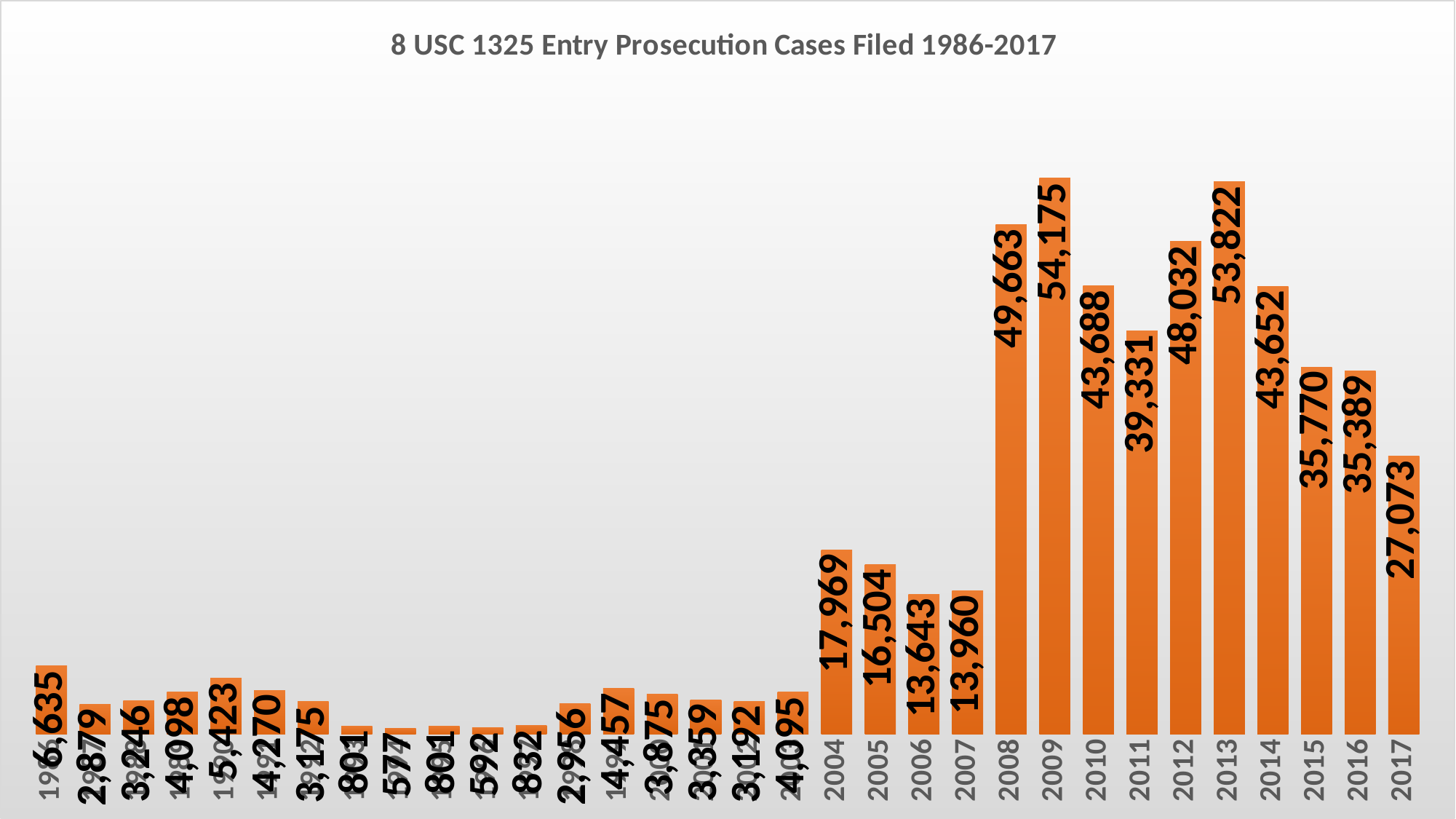
Do the values rise or fall from 2013 to 2017? Fall What is the difference between the cases filed in 2009 and in 2013? 353 Which year has the highest number of cases filed? 2009 How many cases were filed in 2004? 17,969 How many years (bars) are shown in the chart? 32 How many cases were filed in 2009? 54,175 What type of chart is shown on the slide? Bar chart How many cases were filed in 2012? 48,032 What is the title of the chart? 8 USC 1325 Entry Prosecution Cases Filed 1986-2017 What is the difference between the cases filed in 2008 and in 2007? 35,703 Which year had more cases filed, 2011 or 2012? 2012 How many cases were filed in 2017? 27,073